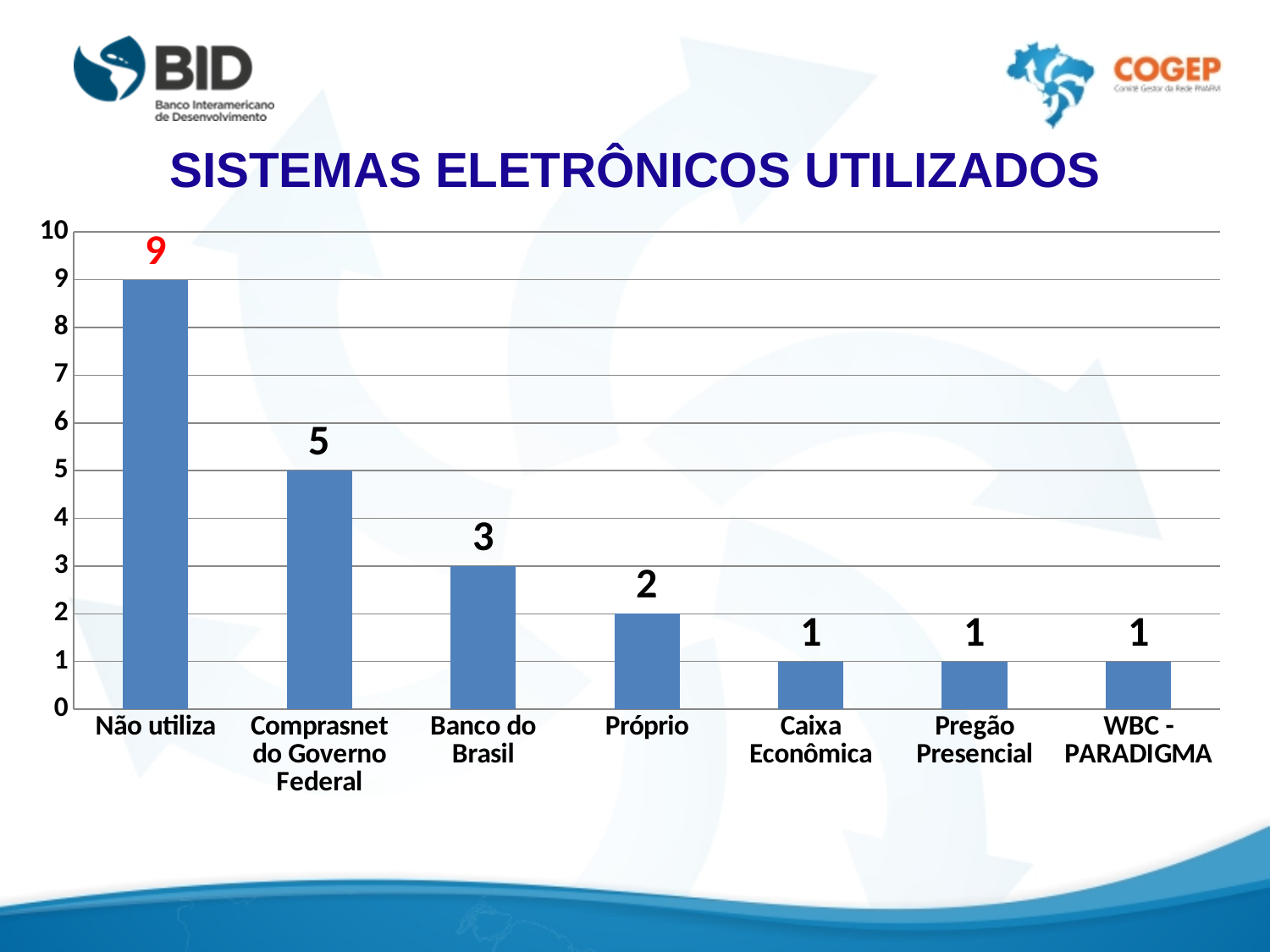
What is the value for Não utiliza? 9 Which is larger, the value for Banco do Brasil or the value for Próprio? Banco do Brasil What kind of chart is shown on the slide? Bar chart What is the title of the chart? SISTEMAS ELETRÔNICOS UTILIZADOS What is the value for Próprio? 2 Which category has the highest value? Não utiliza How many categories are shown on the x axis? 7 What is the difference between the values for Não utiliza and Comprasnet do Governo Federal? 4 What is the value for Banco do Brasil? 3 Do the values rise or fall from left to right along the x axis? Fall What is the value for Comprasnet do Governo Federal? 5 How many categories have a value of 1? 3